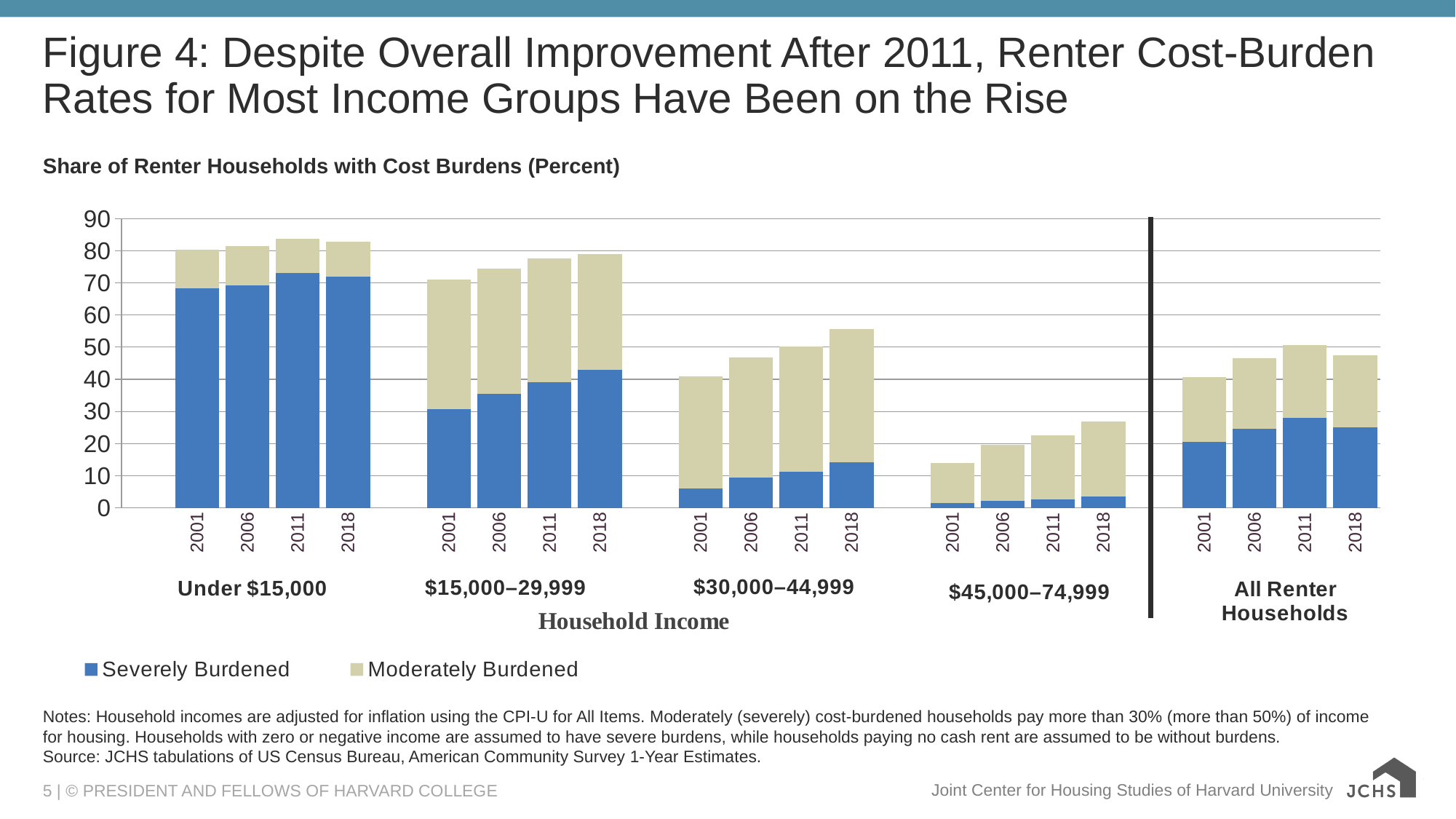
How many income groups (including All Renter Households) are shown on the x axis? 5 Which income group has the highest total cost-burdened share in 2018? Under $15,000 How many series does the legend list? 2 Do the total cost-burdened shares for the $30,000–44,999 group rise or fall from 2001 to 2018? rise In the $15,000–29,999 group, which year has the highest total cost-burdened share? 2018 For All Renter Households, is the total cost-burdened share larger in 2011 or in 2018? 2011 What kind of chart is shown on the slide? Stacked bar chart Is the total cost-burdened share for the Under $15,000 group in 2011 greater or less than 80? greater How many years are plotted for each income group? 4 What are the two series named in the legend? Severely Burdened and Moderately Burdened Is the total cost-burdened share for the $45,000–74,999 group in 2001 greater or less than 20? less Is the severely burdened share for the $30,000–44,999 group in 2018 greater or less than 20? less